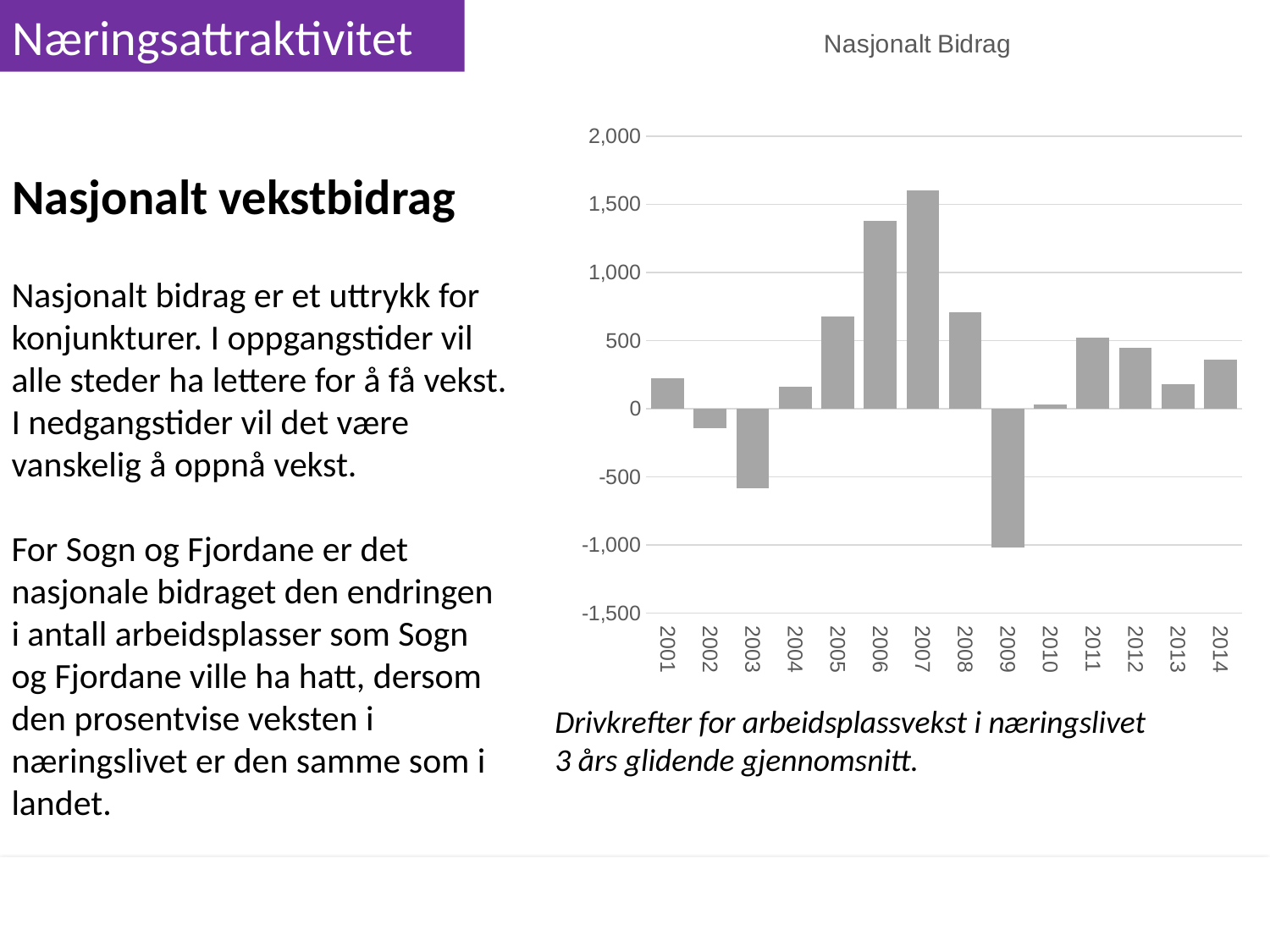
How many years are shown on the x axis of the chart? 14 What is the title of the chart? Nasjonalt Bidrag Is the value for 2003 greater or less than -500? less Which year has the lowest value in the chart? 2009 Which year has the highest value in the chart? 2007 Which year has the larger value, 2011 or 2013? 2011 Is the value for 2007 greater or less than 1,500? greater Do the values rise or fall from 2007 to 2009? fall Which year has the larger value, 2006 or 2008? 2006 Is the value for 2005 greater or less than 500? greater What kind of chart is shown on the slide? bar chart